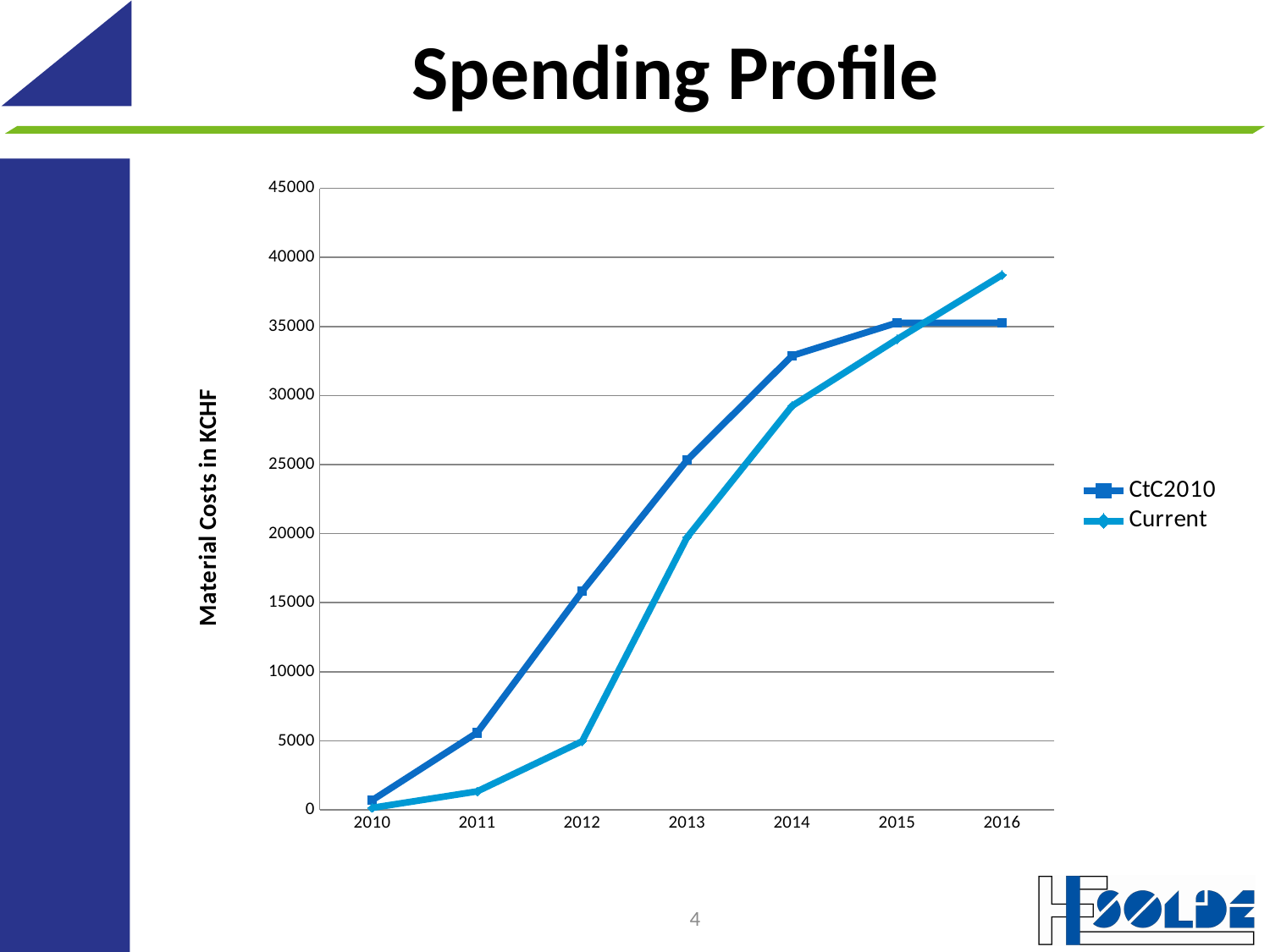
What is the title of the vertical axis? Material Costs in KCHF Does the Current series rise or fall from 2010 to 2016? rise In 2013, which series has the larger value, CtC2010 or Current? CtC2010 In which year is the Current series at its lowest value? 2010 In which year does the Current series reach its highest value? 2016 What are the two series named in the legend? CtC2010 and Current Is the value for Current in 2012 greater or less than 10000? less What kind of chart is shown on the slide? line chart How many years are plotted along the x axis? 7 Is the value for Current in 2016 greater or less than 35000? greater Is the value for CtC2010 in 2014 greater or less than 30000? greater How many series does the legend list? 2